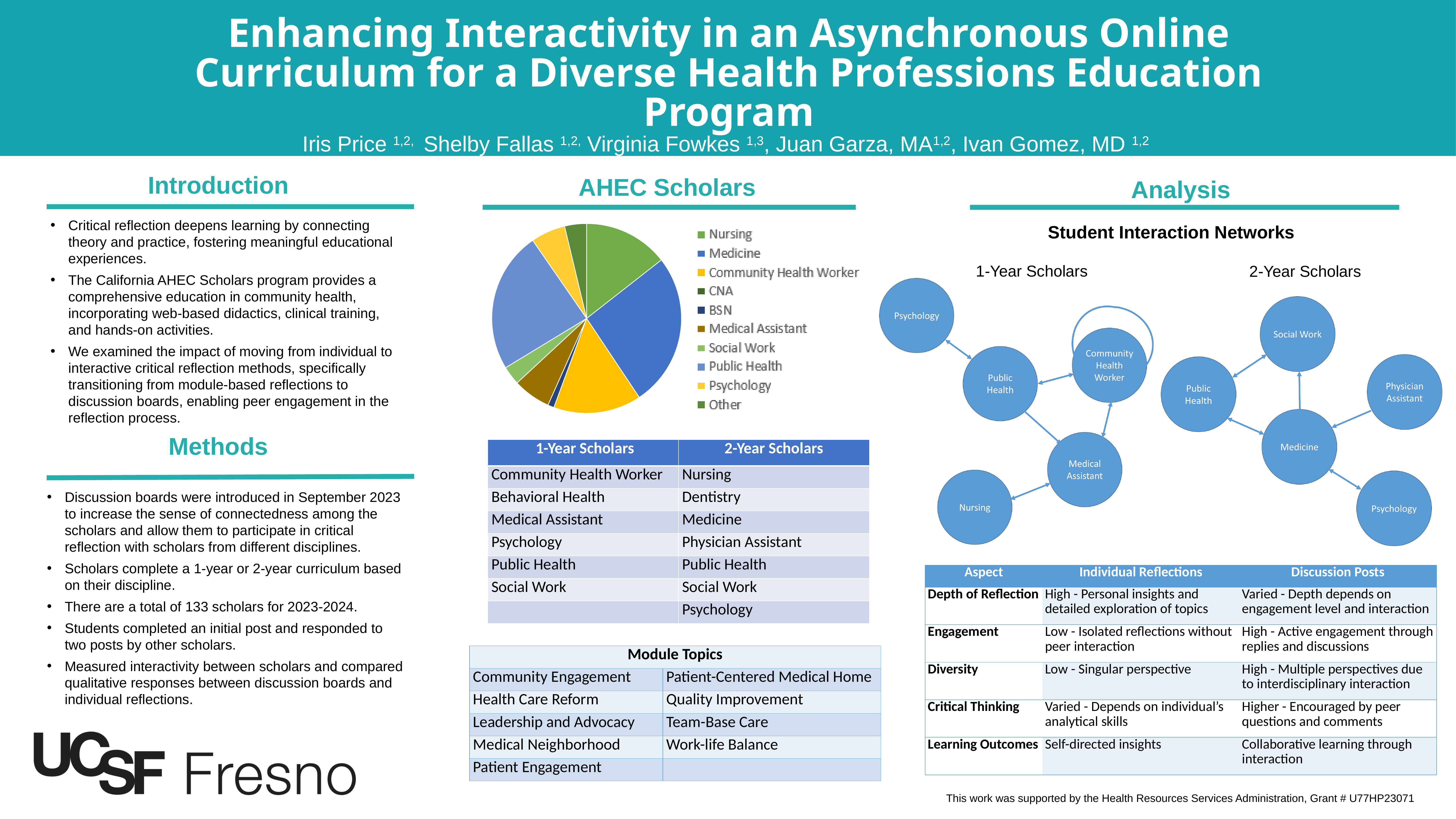
In the AHEC Scholars pie chart, which slice is larger, Medicine or CNA? Medicine In the AHEC Scholars pie chart, which slice is larger, Public Health or Medical Assistant? Public Health In the AHEC Scholars pie chart, which slice is larger, Community Health Worker or Social Work? Community Health Worker What is the title above the pie chart? AHEC Scholars Which category in the AHEC Scholars pie chart is shown in blue, according to the legend? Medicine How many categories does the legend of the AHEC Scholars pie chart list? 10 Which category has the smallest slice in the AHEC Scholars pie chart? BSN What kind of chart is shown under the heading AHEC Scholars? pie chart